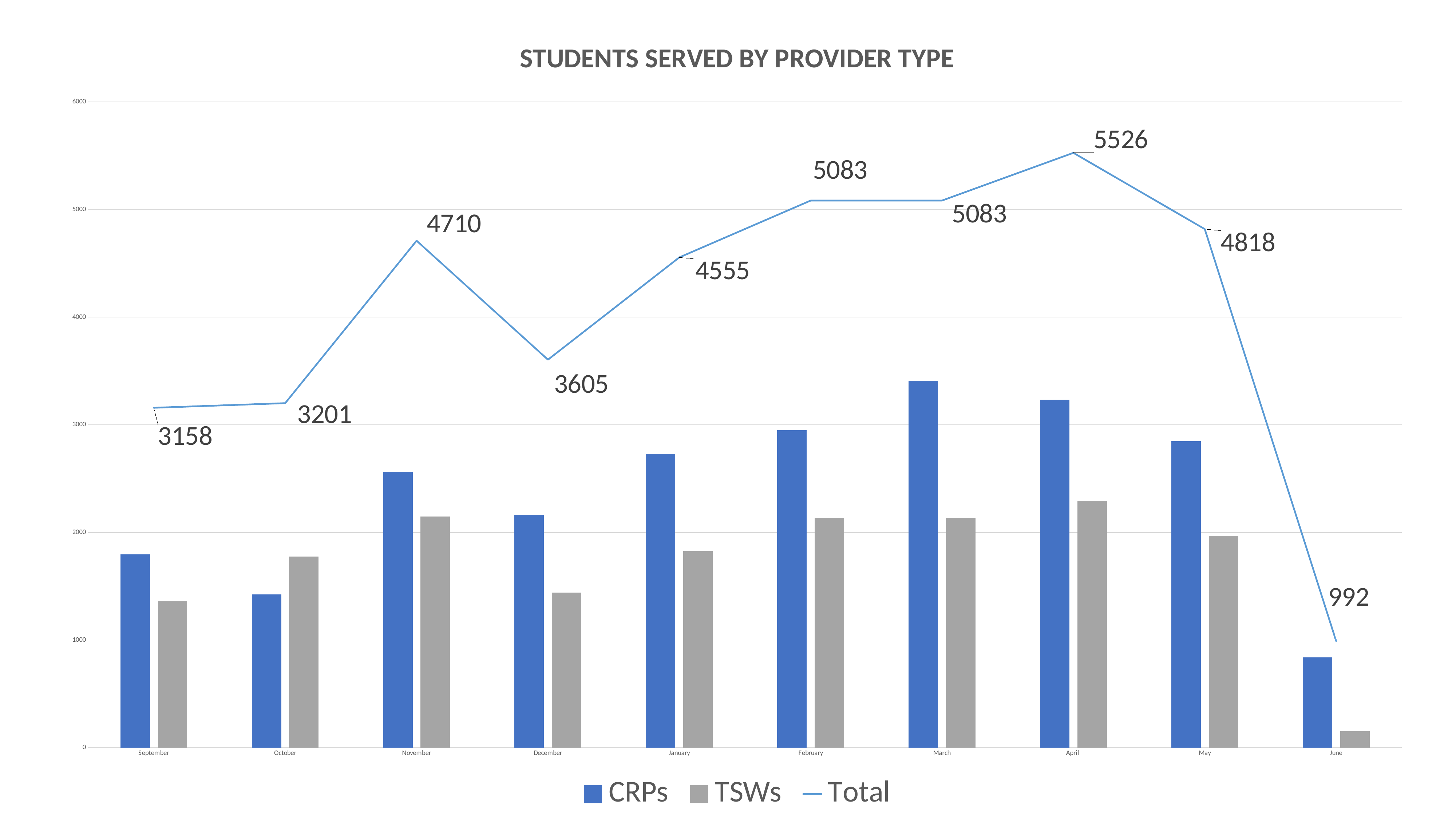
What is the difference between the Total for November and the Total for December? 1105 Is the TSWs value for September greater or less than 2000? less What is the Total value for April? 5526 Does the Total rise or fall from April to June? fall How many months are shown on the x axis? 10 What is the Total value for June? 992 In which month is the Total lowest? June In which month is the Total highest? April Which is larger, the Total for January or the Total for May? May What is the Total value for December? 3605 Is the CRPs value for March greater or less than 3000? greater How many series does the legend list? 3